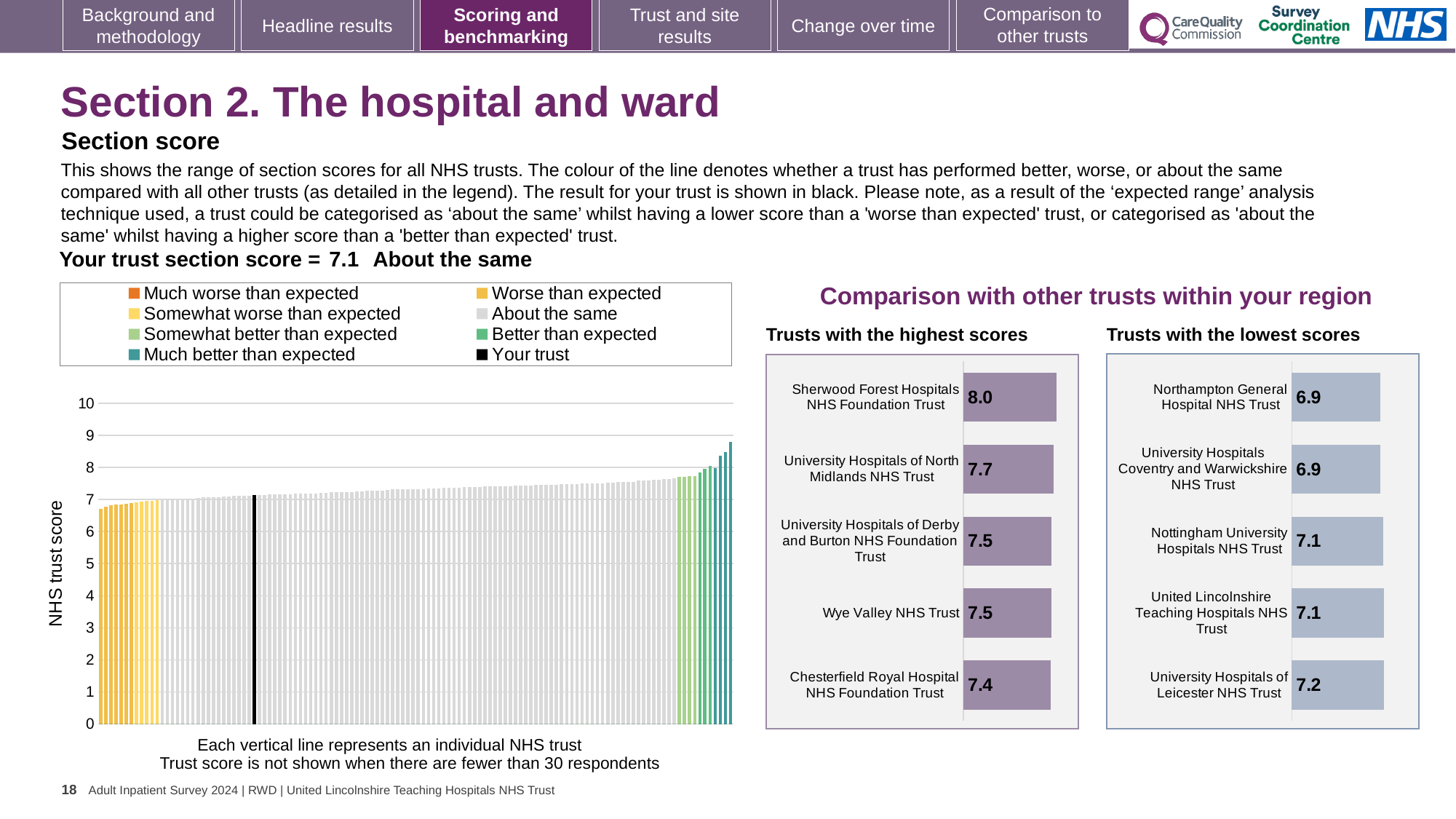
How many trusts are shown in the 'Trusts with the lowest scores' chart? 5 In the 'Trusts with the lowest scores' chart, which trust has the highest score? University Hospitals of Leicester NHS Trust In the large chart on the left, do the trust scores rise or fall from left to right? Rise In the 'Trusts with the highest scores' chart, what is the score for Chesterfield Royal Hospital NHS Foundation Trust? 7.4 In the 'Trusts with the highest scores' chart, which has the larger score: Wye Valley NHS Trust or Chesterfield Royal Hospital NHS Foundation Trust? Wye Valley NHS Trust In the 'Trusts with the lowest scores' chart, what is the difference between the scores of University Hospitals of Leicester NHS Trust and Northampton General Hospital NHS Trust? 0.3 How many entries does the legend of the large chart on the left list? 8 In the 'Trusts with the highest scores' chart, what is the difference between the scores of Sherwood Forest Hospitals NHS Foundation Trust and Chesterfield Royal Hospital NHS Foundation Trust? 0.6 In the 'Trusts with the lowest scores' chart, what is the score for Nottingham University Hospitals NHS Trust? 7.1 In the 'Trusts with the highest scores' chart, what is the score for Sherwood Forest Hospitals NHS Foundation Trust? 8.0 In the 'Trusts with the highest scores' chart, which trust has the highest score? Sherwood Forest Hospitals NHS Foundation Trust What kind of chart is the large chart on the left showing NHS trust scores? Bar chart